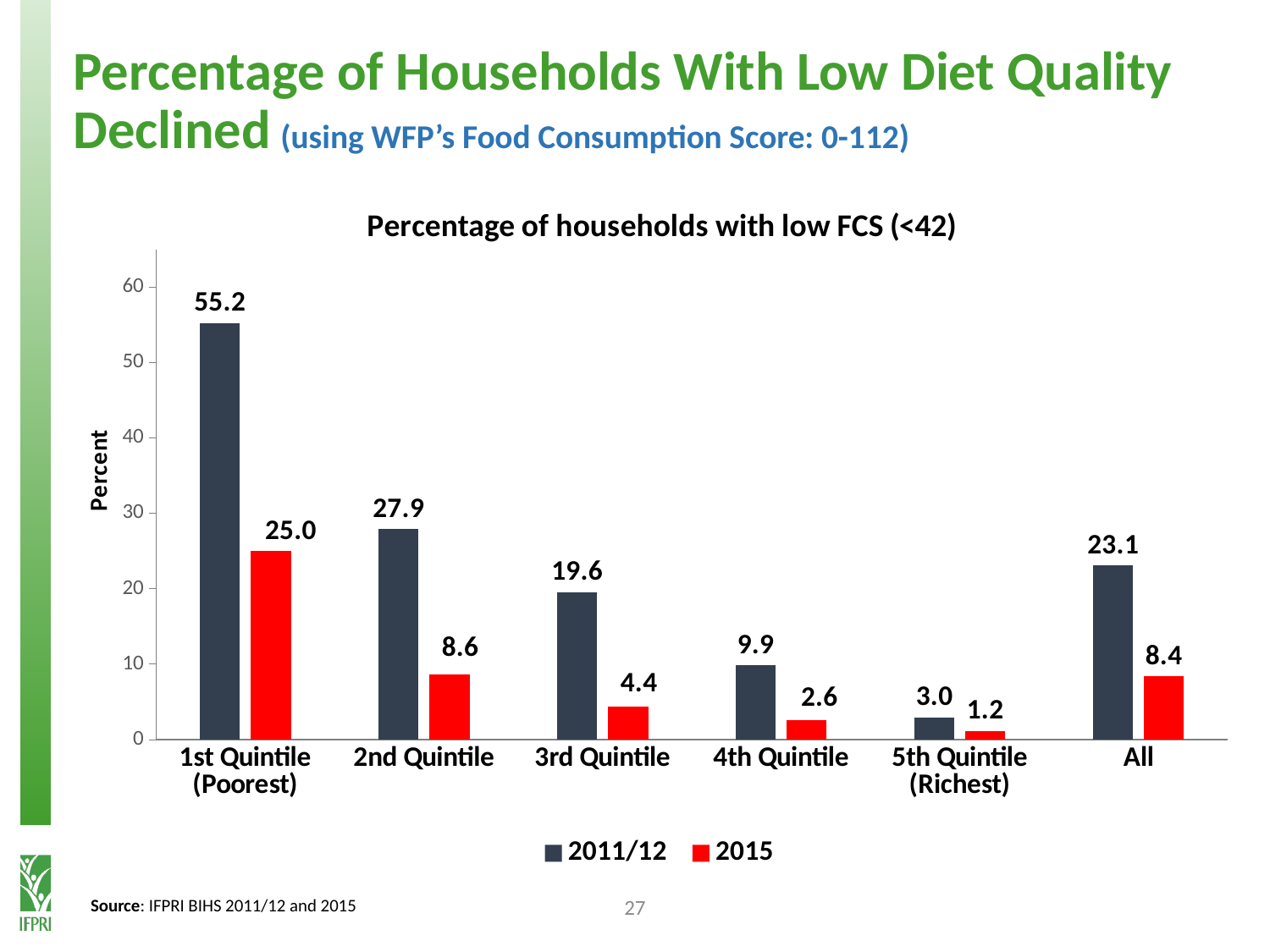
What is the difference between the 2011/12 and 2015 values for 2nd Quintile? 19.3 Which is larger: the 2015 value for 1st Quintile (Poorest) or the 2011/12 value for All? 2015 value for 1st Quintile (Poorest) What is the value for All in the 2015 series? 8.4 Do the 2011/12 values rise or fall from the 1st Quintile to the 5th Quintile? Fall What kind of chart is shown on the slide? Bar chart Which category has the lowest value in the 2015 series? 5th Quintile (Richest) What is the title of the chart? Percentage of households with low FCS (<42) What is the value for 3rd Quintile in the 2015 series? 4.4 What is the value for 1st Quintile (Poorest) in the 2011/12 series? 55.2 Which category has the highest value in the 2011/12 series? 1st Quintile (Poorest) How many series does the legend list? 2 How many categories are shown on the x axis? 6